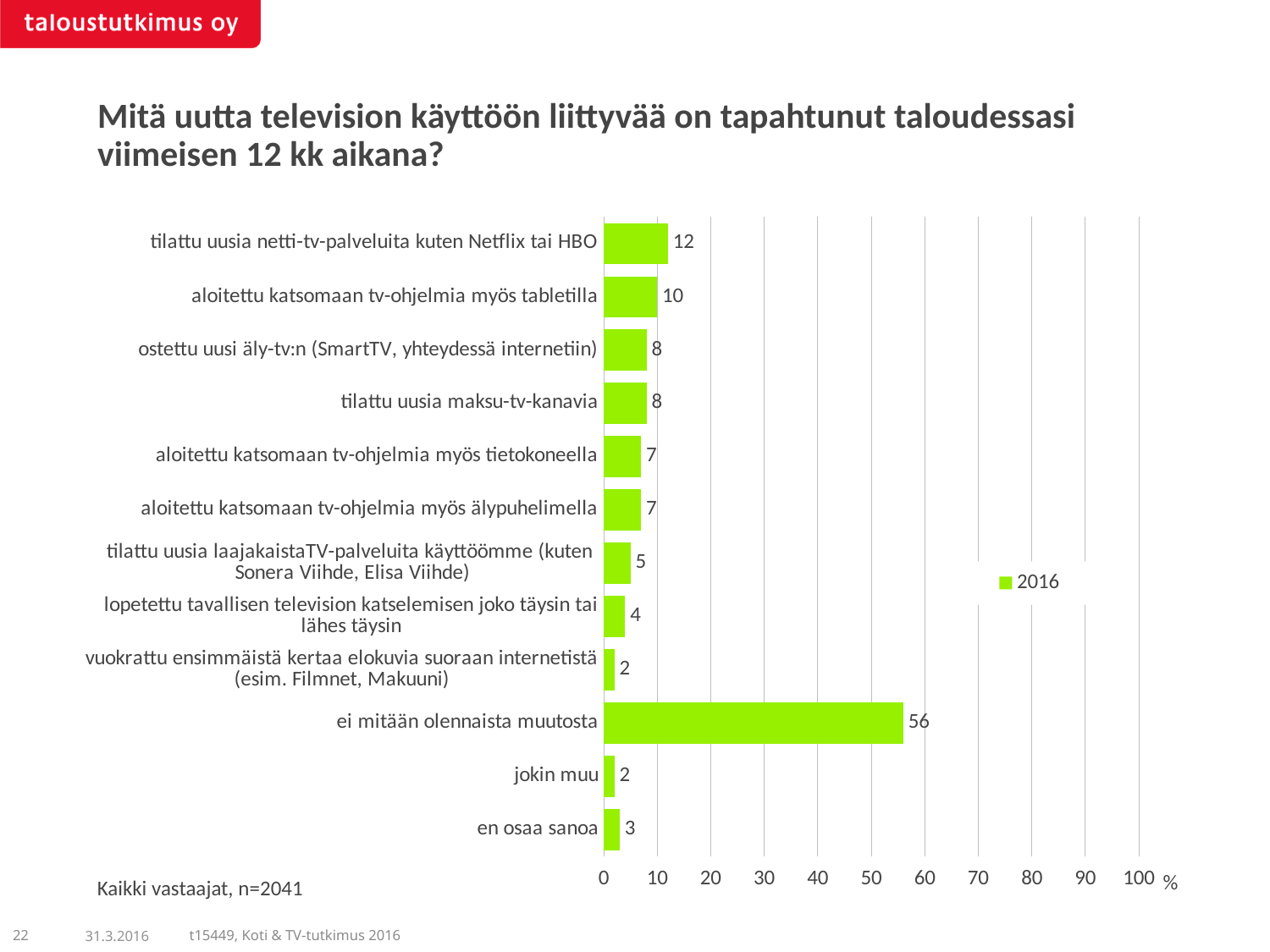
How many categories are shown in the chart? 12 Which is larger: the value for "aloitettu katsomaan tv-ohjelmia myös tabletilla" or the value for "tilattu uusia maksu-tv-kanavia"? aloitettu katsomaan tv-ohjelmia myös tabletilla Is the value for "ei mitään olennaista muutosta" greater or less than 50? greater Which category has the highest value? ei mitään olennaista muutosta What series name is shown in the legend? 2016 How many series does the legend list? 1 What kind of chart is shown on the slide? bar chart What is the difference between the values for "ei mitään olennaista muutosta" and "tilattu uusia netti-tv-palveluita kuten Netflix tai HBO"? 44 What is the value for "tilattu uusia netti-tv-palveluita kuten Netflix tai HBO"? 12 What is the value for "ei mitään olennaista muutosta"? 56 What is the value for "en osaa sanoa"? 3 What is the value for "aloitettu katsomaan tv-ohjelmia myös tabletilla"? 10